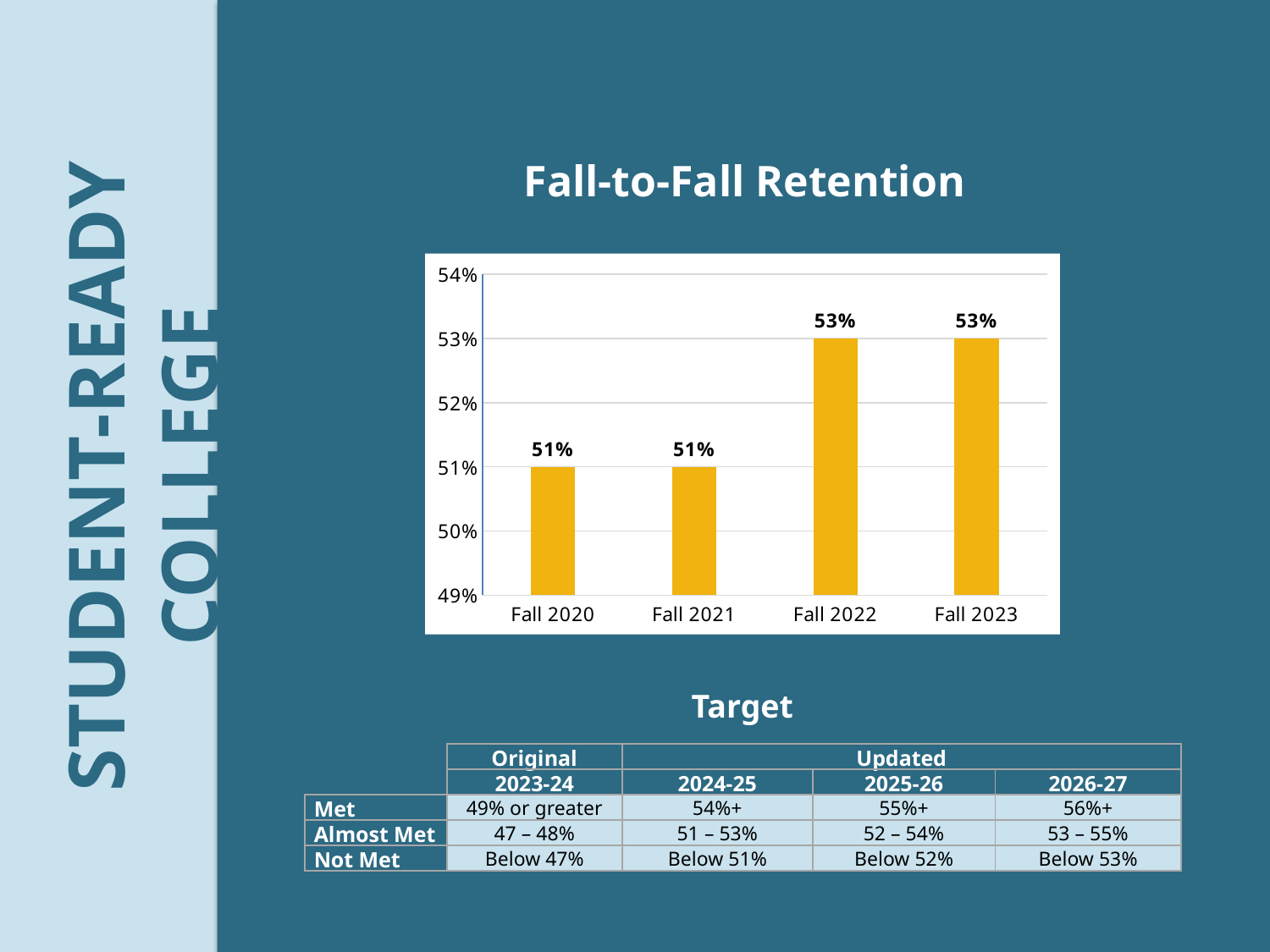
Do the retention values rise or fall from Fall 2020 to Fall 2023? rise What is the Fall-to-Fall Retention value for Fall 2023? 53% How many categories are shown on the x axis of the chart? 4 Which is larger, the retention value for Fall 2021 or Fall 2023? Fall 2023 Is the retention value for Fall 2020 greater or less than 52%? less What is the lowest value shown on the chart's y axis? 49% Is the retention value for Fall 2023 greater or less than 52%? greater What kind of chart is shown on the slide? bar chart What is the Fall-to-Fall Retention value for Fall 2020? 51% What is the title of the chart? Fall-to-Fall Retention What is the difference between the Fall 2022 and Fall 2021 retention values? 2% What is the Fall-to-Fall Retention value for Fall 2022? 53%